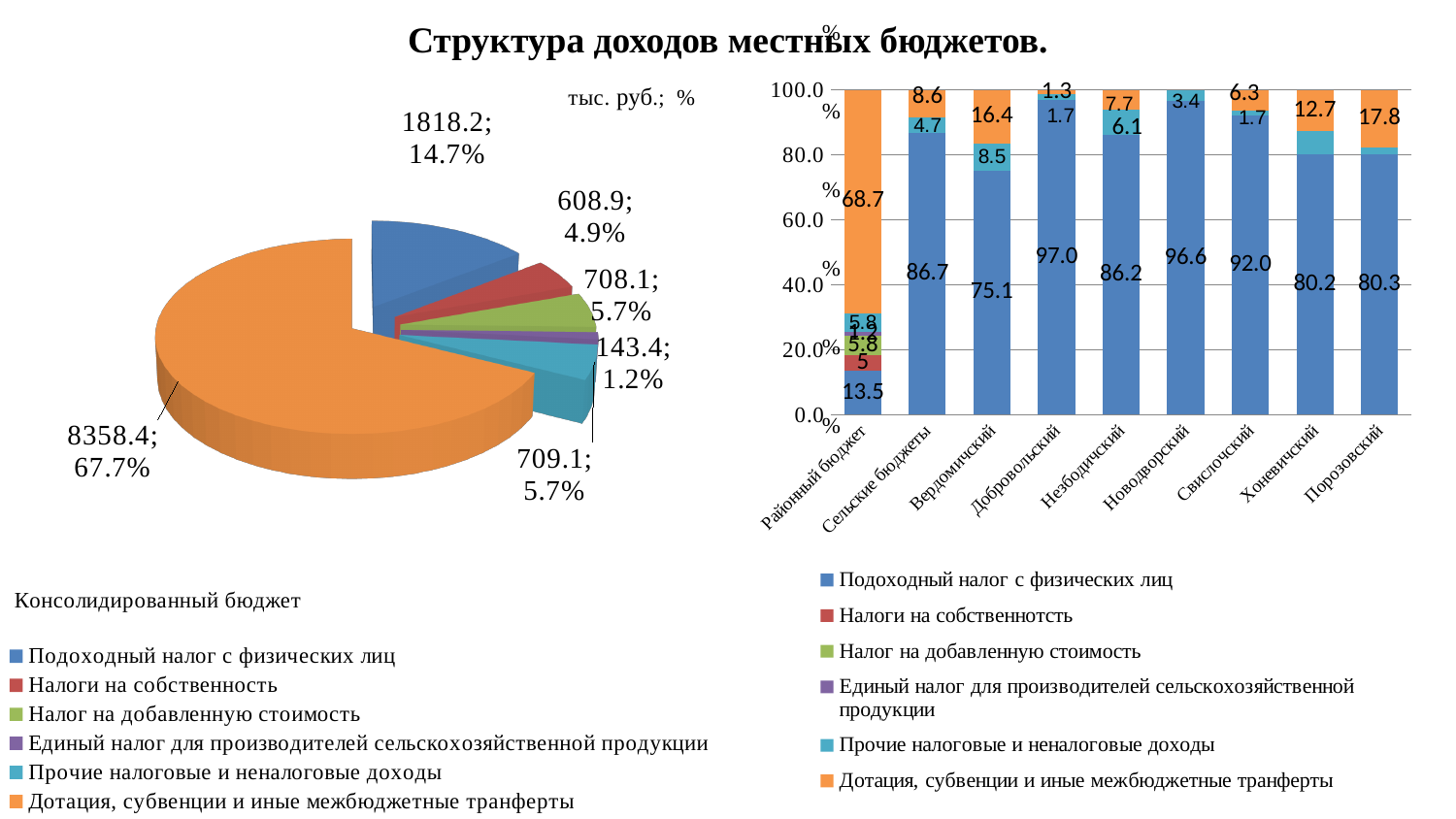
In the pie chart on the left, what value is shown for the largest slice (Дотация, субвенции и иные межбюджетные трансферты)? 8358.4; 67.7% In the pie chart on the left, what share does the blue slice (Подоходный налог с физических лиц) have? 14.7% In the bar chart on the right, how many categories are shown on the x axis? 9 In the bar chart on the right, which is larger: the Подоходный налог с физических лиц value for Вердомичский or for Незбодичский? Незбодичский In the bar chart on the right, which category has the lowest value for Подоходный налог с физических лиц? Районный бюджет What type of chart is shown on the right side of the slide? Stacked bar chart In the pie chart on the left, which category has the smallest slice? Единый налог для производителей сельскохозяйственной продукции In the bar chart on the right, what is the value of Подоходный налог с физических лиц for Добровольский? 97.0 In the bar chart on the right, what is the value of Дотация, субвенции и иные межбюджетные трансферты for Районный бюджет? 68.7 In the pie chart on the left, what is the difference between the values 1818.2 and 608.9? 1209.3 In the pie chart on the left, how many slices are there? 6 In the bar chart on the right, how many series does the legend list? 6